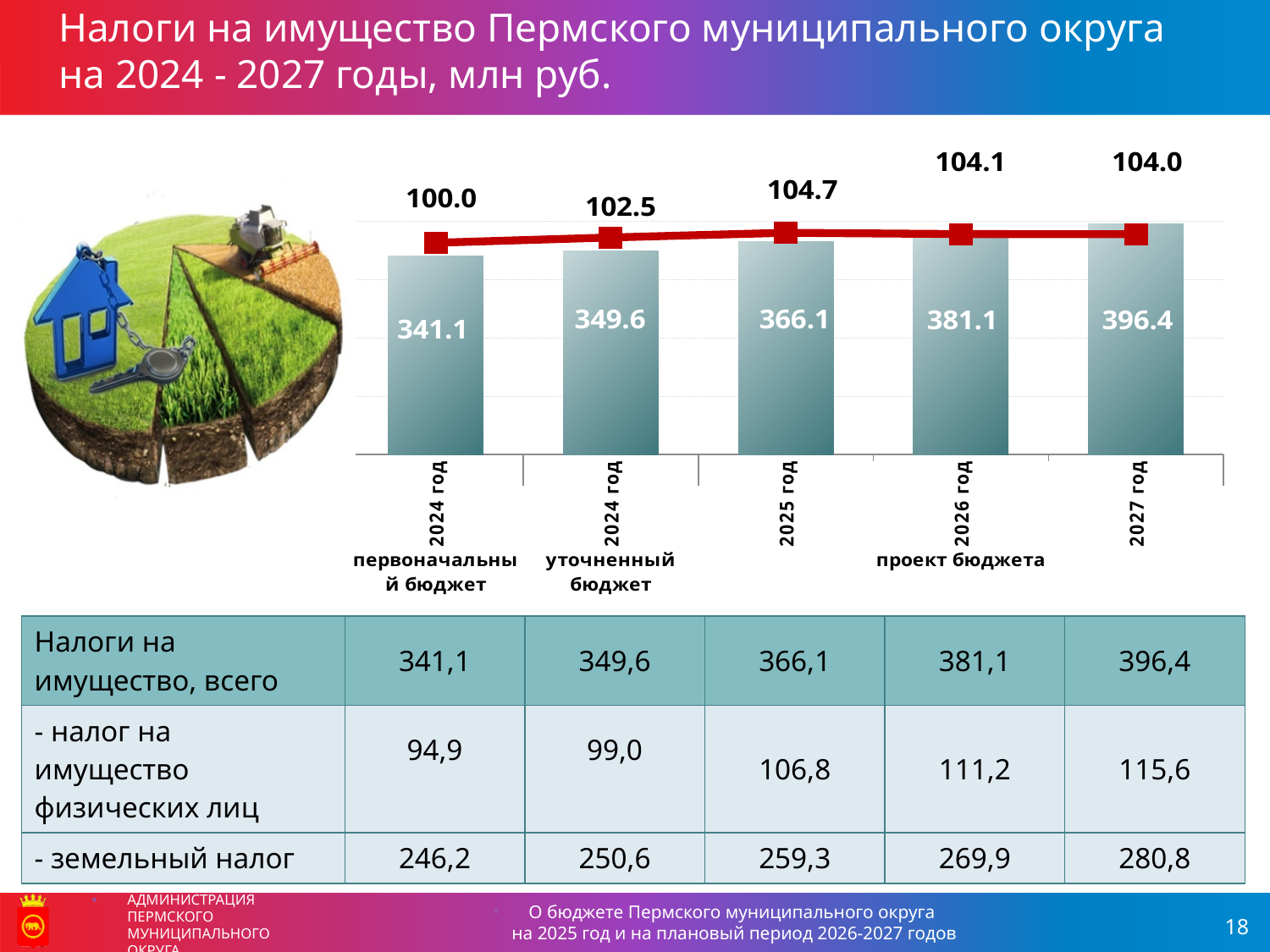
What is the bar value for 2024 год первоначальный бюджет? 341.1 Which category has the highest bar value? 2027 год What is the line value shown above the 2024 год уточненный бюджет bar? 102.5 Which is larger, the bar value for 2025 год or for 2026 год? 2026 год What is the difference between the bar values for 2024 год уточненный бюджет and 2024 год первоначальный бюджет? 8.5 What is the difference between the bar values for 2027 год and 2026 год? 15.3 Which category has the lowest bar value? 2024 год первоначальный бюджет How many bars are plotted in the chart? 5 What is the bar value for 2025 год in the chart? 366.1 Do the bar values rise or fall from left to right across the categories? rise Which category has the highest line value? 2025 год What is the line (red marker) value shown above the 2026 год bar? 104.1